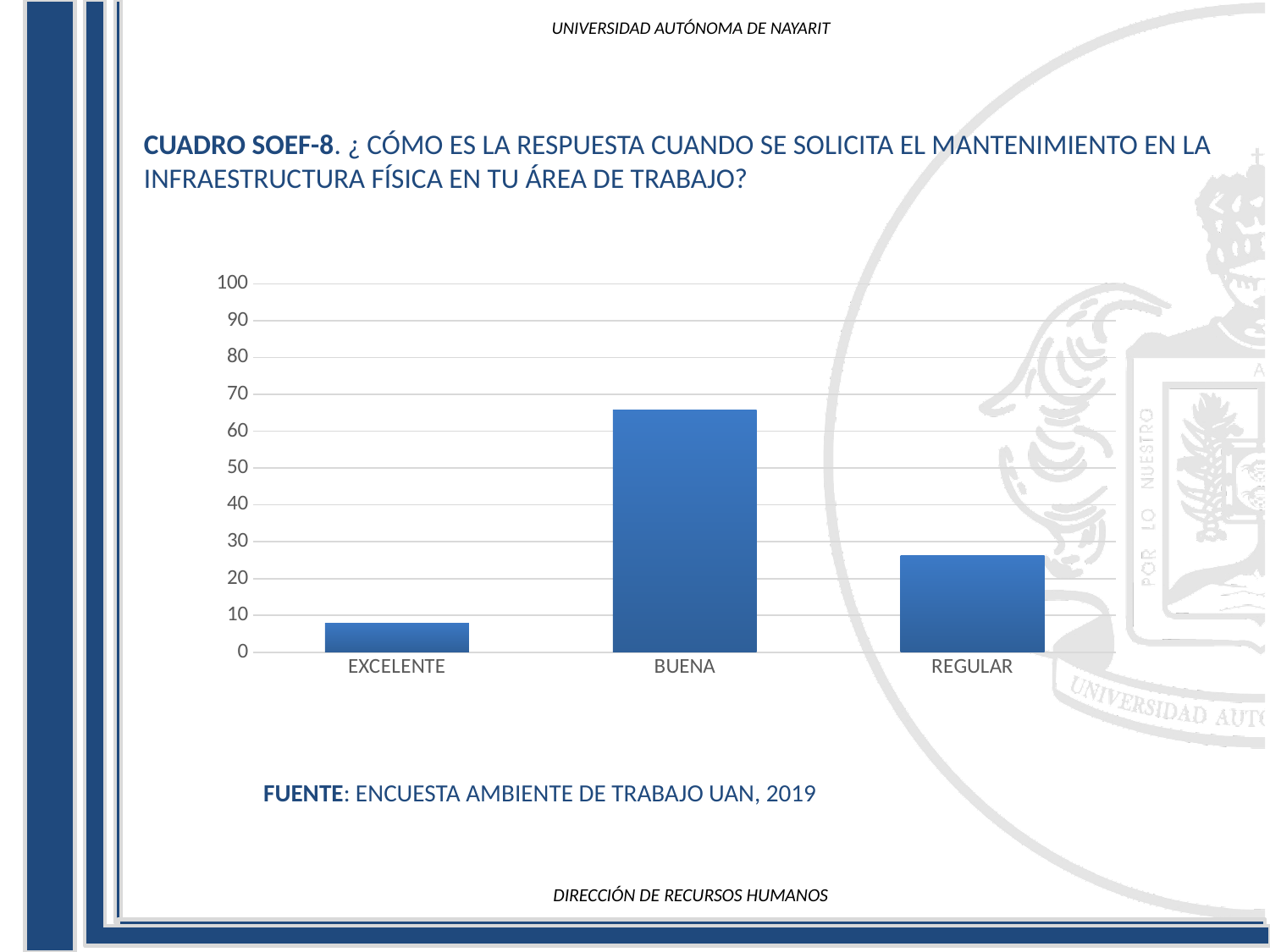
Is the value for BUENA greater or less than 60? greater Is the value for REGULAR greater or less than 20? greater Is the value for REGULAR greater or less than 30? less What is the highest value shown on the vertical axis of the chart? 100 How many categories are shown on the x axis of the chart? 3 Which category has the lowest bar? EXCELENTE What source is cited below the chart? ENCUESTA AMBIENTE DE TRABAJO UAN, 2019 What kind of chart is shown on the slide? bar chart Which category has the highest bar? BUENA Which is larger, the value for REGULAR or the value for EXCELENTE? REGULAR